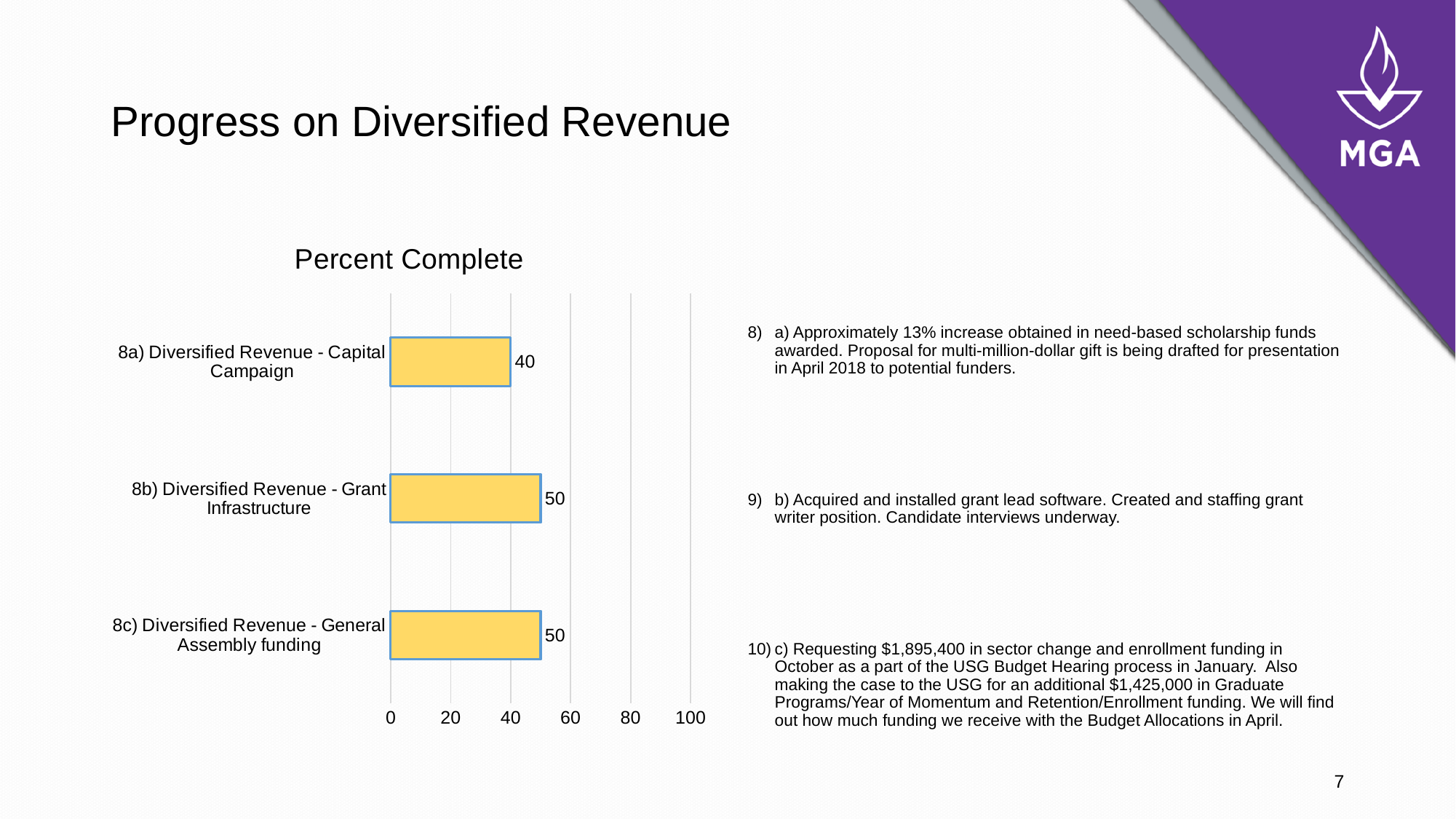
What is the value for 8a) Diversified Revenue - Capital Campaign? 40 What kind of chart is shown on the slide? bar chart How many categories are shown in the chart? 3 What is the maximum value shown on the chart's axis? 100 Is the value for 8a) Diversified Revenue - Capital Campaign greater or less than 60? less What is the difference between the values for 8b) Diversified Revenue - Grant Infrastructure and 8a) Diversified Revenue - Capital Campaign? 10 What is the value for 8c) Diversified Revenue - General Assembly funding? 50 What is the title of the chart? Percent Complete Which category has the lowest value? 8a) Diversified Revenue - Capital Campaign Which is larger, the value for 8a) Diversified Revenue - Capital Campaign or the value for 8c) Diversified Revenue - General Assembly funding? 8c) Diversified Revenue - General Assembly funding What is the value for 8b) Diversified Revenue - Grant Infrastructure? 50